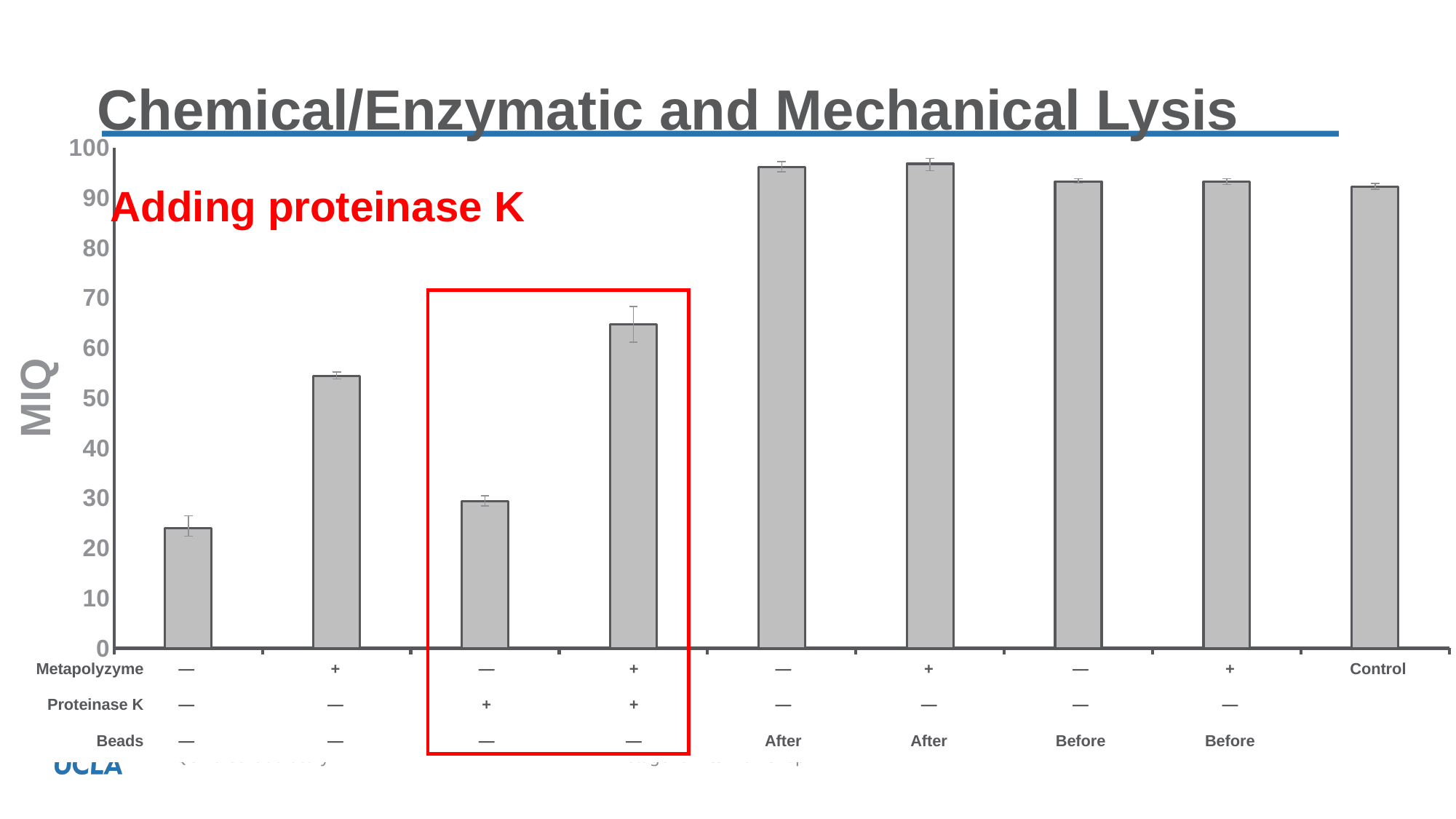
Which has a higher MIQ value: the bar with Metapolyzyme +, Proteinase K —, Beads — or the bar with Metapolyzyme +, Proteinase K +, Beads —? Metapolyzyme +, Proteinase K +, Beads — Is the MIQ value for the first bar (Metapolyzyme —, Proteinase K —, Beads —) greater or less than 30? less How many bars are plotted in the chart? 9 Is the MIQ value for the bar with Metapolyzyme —, Proteinase K +, Beads — greater or less than 40? less Is the MIQ value for the bar with Metapolyzyme +, Proteinase K —, Beads — greater or less than 50? greater Which has a higher MIQ value: the bar with Metapolyzyme —, Proteinase K —, Beads After or the Control bar? Metapolyzyme —, Proteinase K —, Beads After Which bar has the lowest MIQ value? Metapolyzyme —, Proteinase K —, Beads — (the first bar) What is the label of the y axis? MIQ What is the title of the slide containing the chart? Chemical/Enzymatic and Mechanical Lysis What kind of chart is shown on the slide? bar chart